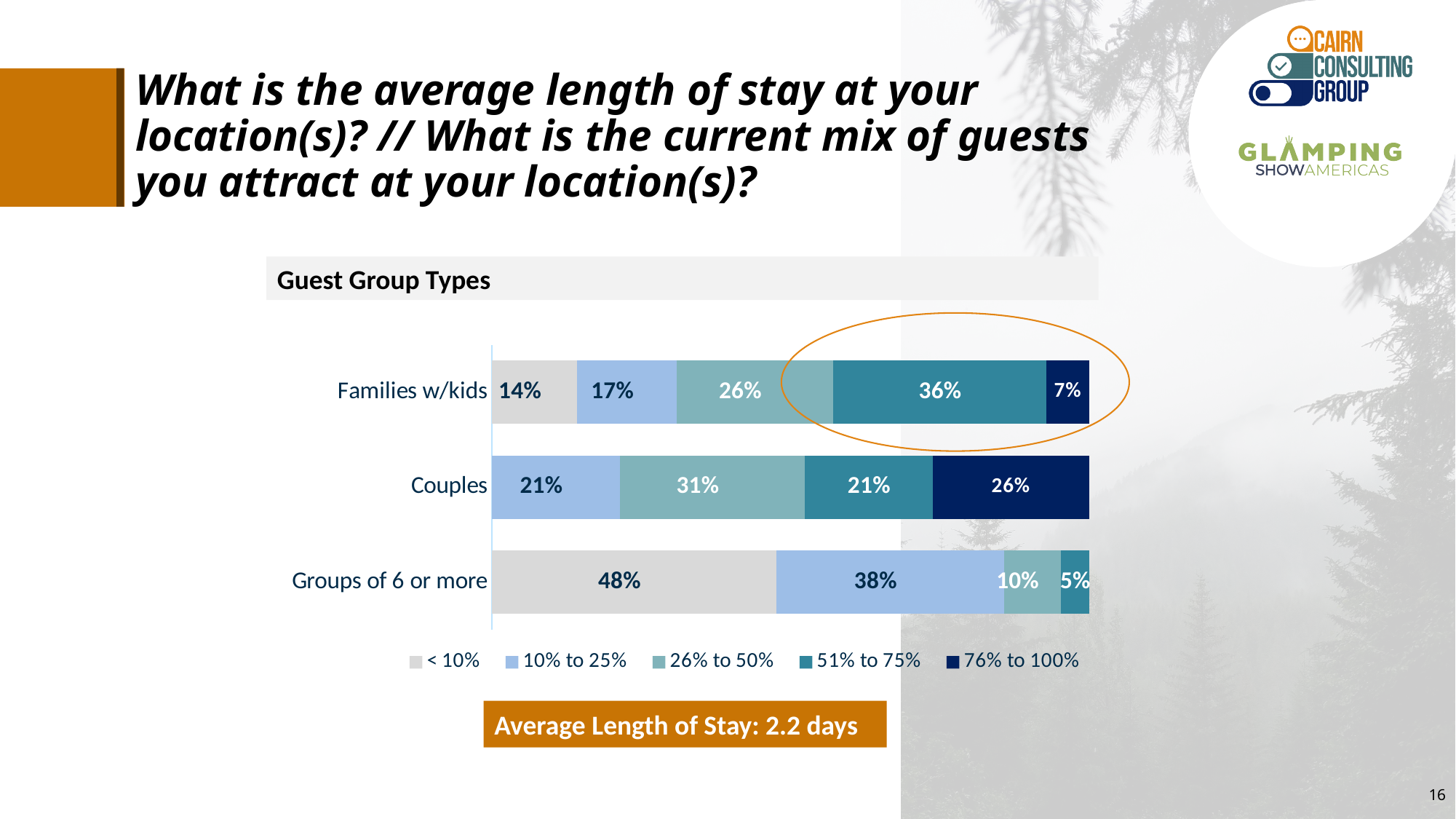
How many guest group categories are plotted in the Guest Group Types chart? 3 In the Guest Group Types chart, what is the value of the "26% to 50%" segment for Couples? 31% In the Guest Group Types chart, which category has the largest "< 10%" segment? Groups of 6 or more How many series does the legend of the Guest Group Types chart list? 5 In the Guest Group Types chart, what is the value of the "< 10%" segment for Groups of 6 or more? 48% In the Guest Group Types chart, which is larger: the "51% to 75%" segment for Families w/kids or for Couples? Families w/kids In the Guest Group Types chart, what is the value of the "76% to 100%" segment for Couples? 26% What average length of stay is stated on the slide? 2.2 days In the Guest Group Types chart, what is the difference between the "10% to 25%" segments for Groups of 6 or more and Families w/kids? 21% What kind of chart is shown under "Guest Group Types"? Stacked bar chart In the Guest Group Types chart, which category has the smallest "76% to 100%" segment? Groups of 6 or more In the Guest Group Types chart, what is the value of the "51% to 75%" segment for Families w/kids? 36%